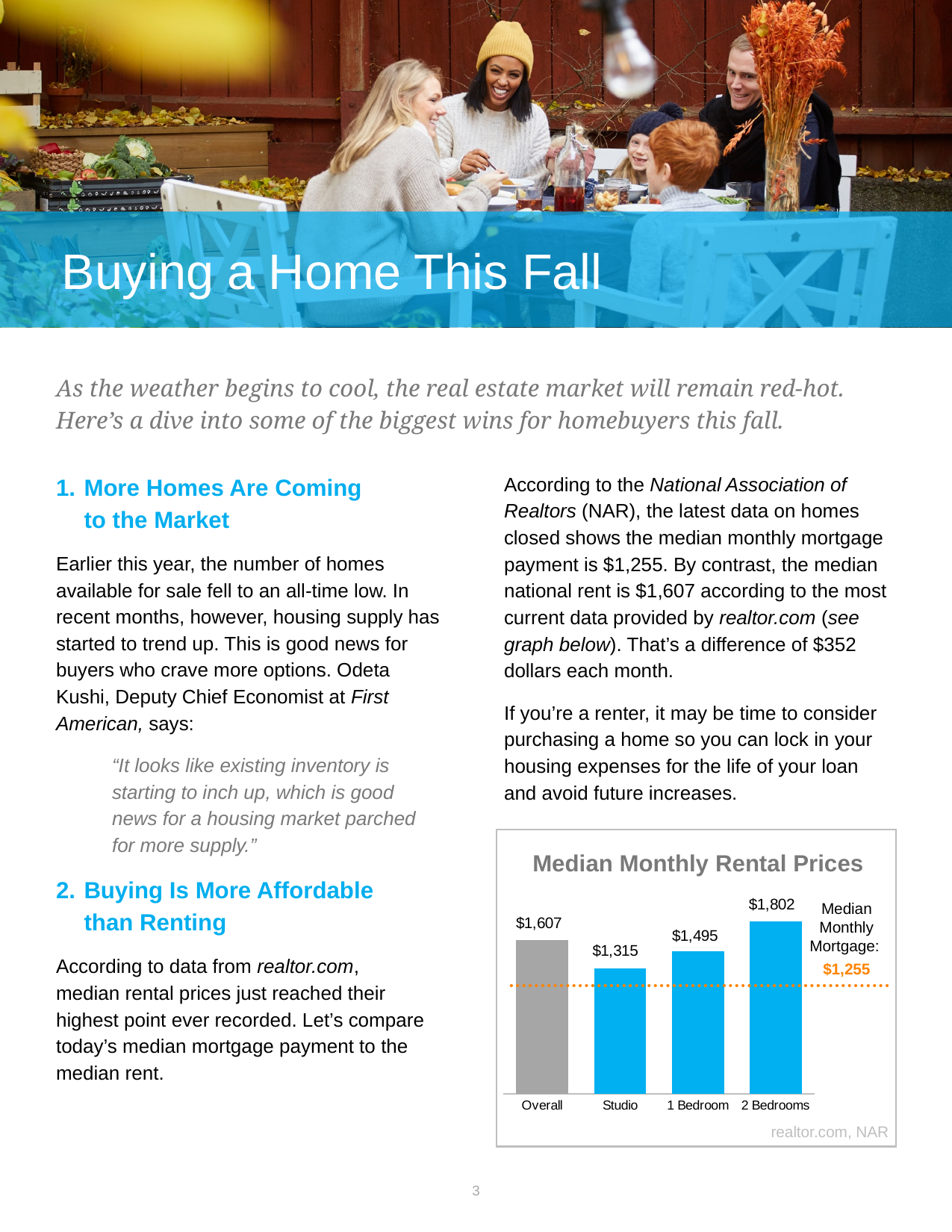
Which category has the lowest median monthly rental price? Studio Which category has the highest median monthly rental price? 2 Bedrooms Which is larger, the median monthly rental price for 1 Bedroom or for Studio? 1 Bedroom How many categories are shown in the Median Monthly Rental Prices chart? 4 What is the Overall median monthly rental price shown in the chart? $1,607 What is the difference between the Overall rental price and the 1 Bedroom rental price? $112 What is the median monthly rental price for a Studio? $1,315 What value does the dotted orange line in the chart represent? Median Monthly Mortgage: $1,255 What is the title of the chart on the slide? Median Monthly Rental Prices What is the difference between the 2 Bedrooms and Studio median monthly rental prices? $487 What kind of chart is the Median Monthly Rental Prices chart? Bar chart What is the median monthly rental price for 2 Bedrooms? $1,802